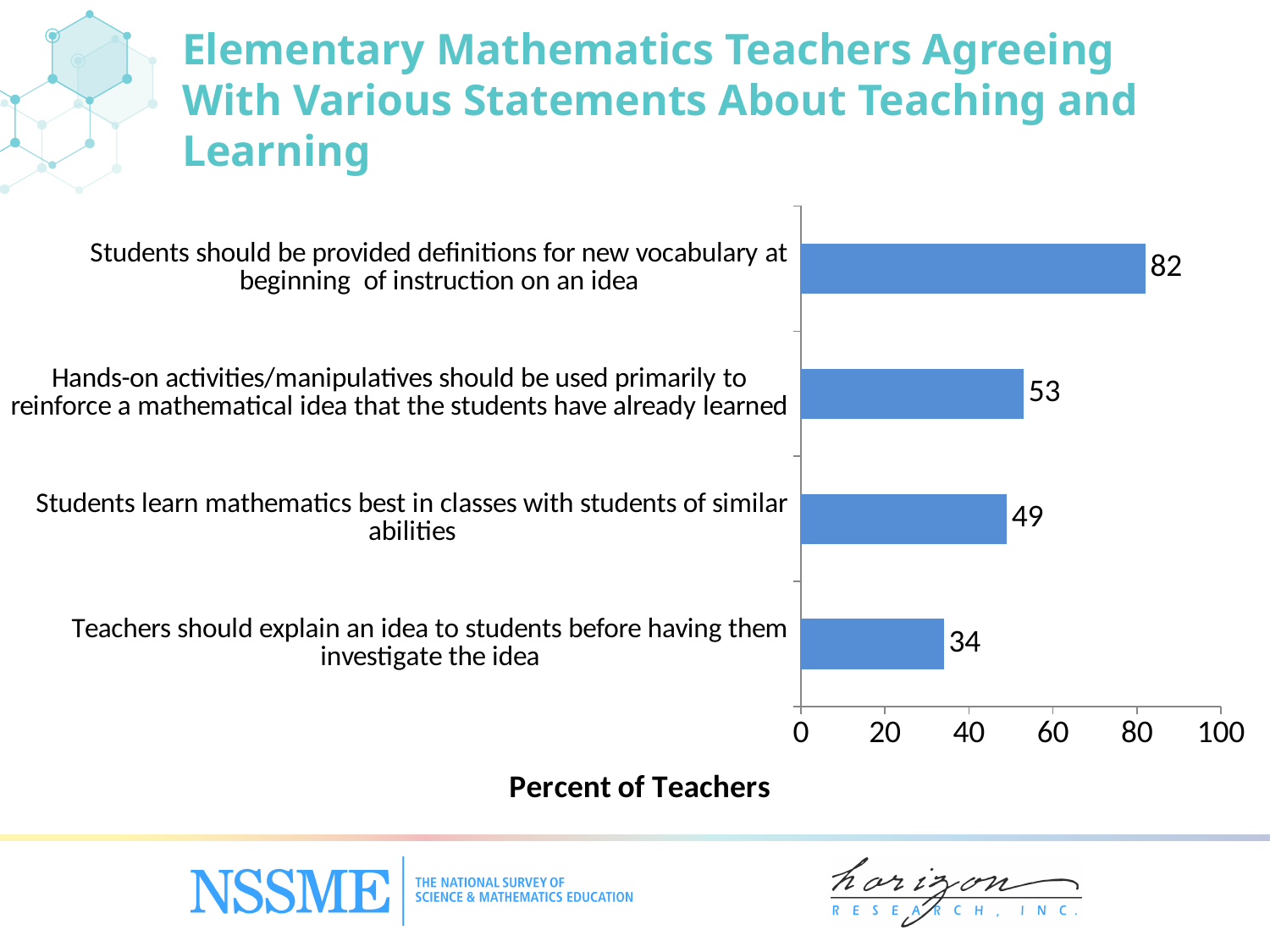
What percent of teachers agree that teachers should explain an idea to students before having them investigate the idea? 34 What is the label of the horizontal axis of the chart? Percent of Teachers Which has a larger percent of teachers agreeing: the hands-on activities statement or the explain-before-investigate statement? Hands-on activities/manipulatives should be used primarily to reinforce a mathematical idea that the students have already learned What percent of elementary mathematics teachers agree that students should be provided definitions for new vocabulary at the beginning of instruction on an idea? 82 What percent of teachers agree that students learn mathematics best in classes with students of similar abilities? 49 What is the difference in percent of teachers between the hands-on activities statement and the similar abilities statement? 4 What kind of chart is shown on the slide? Bar chart Which statement has the highest percent of teachers agreeing? Students should be provided definitions for new vocabulary at beginning of instruction on an idea Which statement has the lowest percent of teachers agreeing? Teachers should explain an idea to students before having them investigate the idea What percent of teachers agree that hands-on activities/manipulatives should be used primarily to reinforce a mathematical idea that the students have already learned? 53 How many statements are shown in the chart? 4 What is the difference in percent of teachers between the vocabulary definitions statement and the explain-before-investigate statement? 48